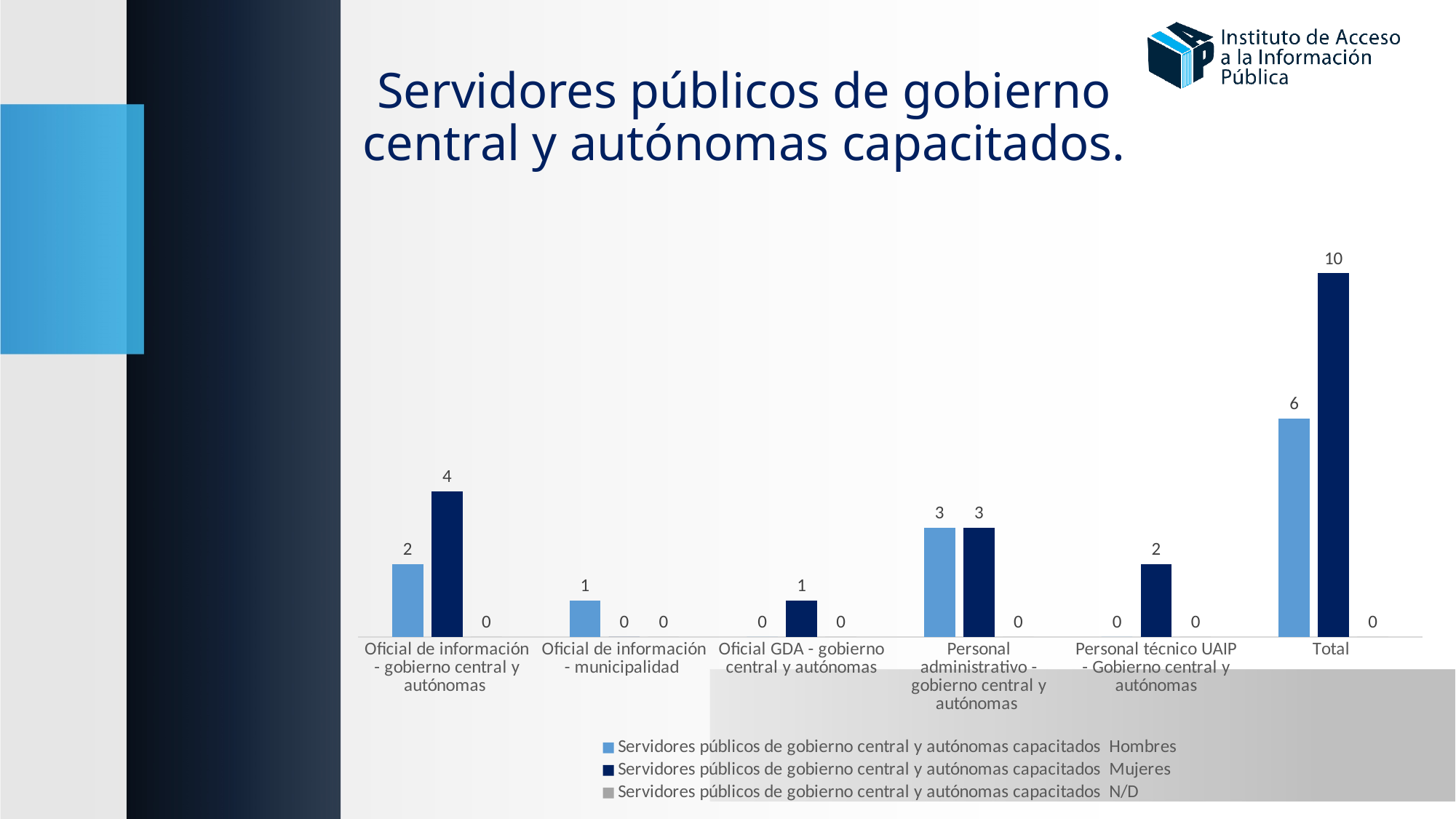
What is the Hombres value for Oficial de información - municipalidad? 1 How many series does the legend list? 3 What is the Mujeres value for Total? 10 What is the Hombres value for Total? 6 How many categories are shown on the x axis? 6 What kind of chart is shown on the slide? Bar chart Which category has the highest Mujeres value? Total What is the Mujeres value for Oficial de información - gobierno central y autónomas? 4 Which is larger for Oficial de información - gobierno central y autónomas: the Hombres value or the Mujeres value? Mujeres What is the difference between the Mujeres and Hombres values for Total? 4 What is the Mujeres value for Personal técnico UAIP - Gobierno central y autónomas? 2 What is the N/D value for Personal administrativo - gobierno central y autónomas? 0